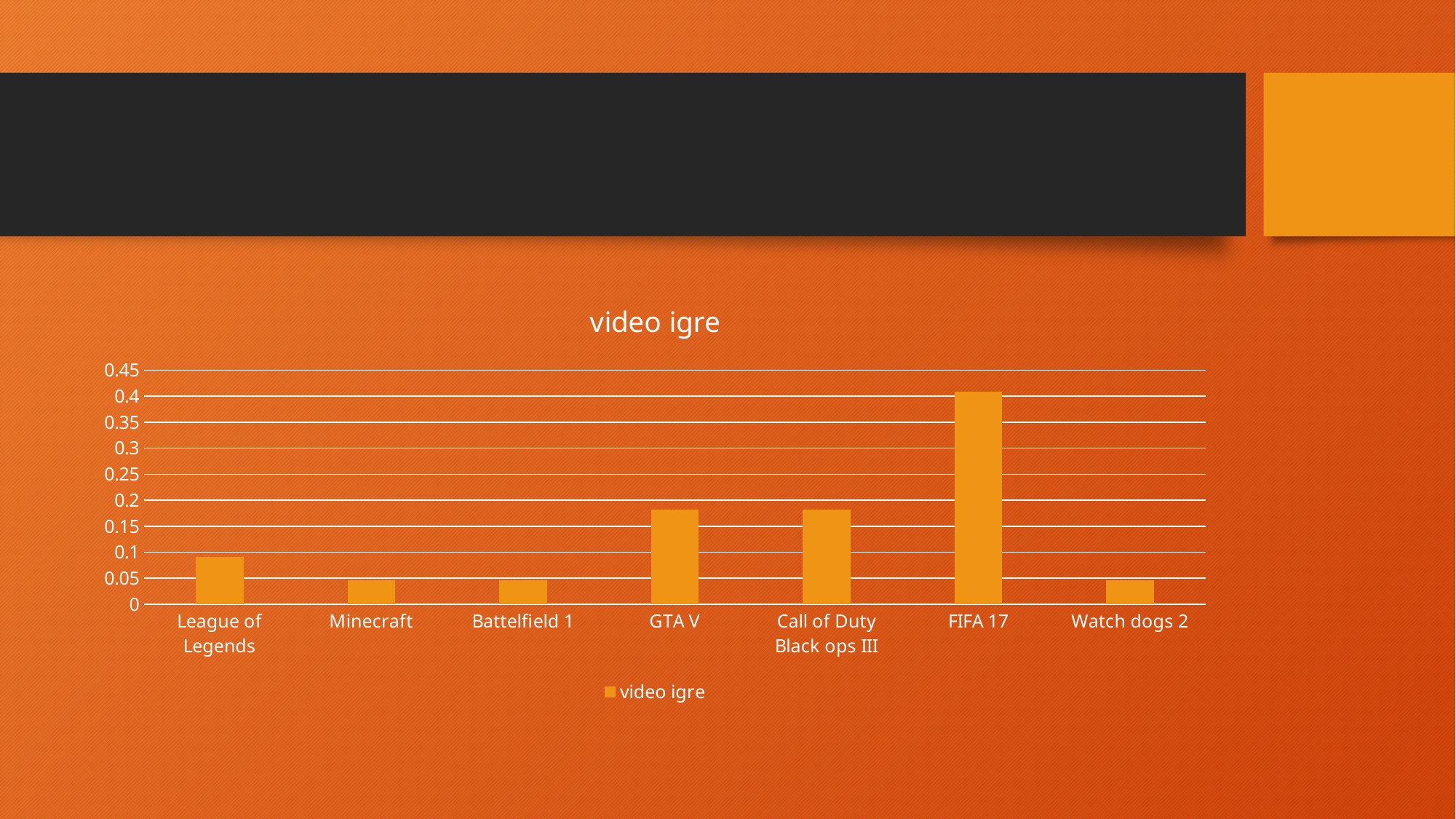
Is the value for FIFA 17 greater or less than 0.35? greater Is the value for GTA V greater or less than 0.15? greater Which is larger, the value for FIFA 17 or the value for GTA V? FIFA 17 What is the title of the chart? video igre Which category has the highest value? FIFA 17 How many series does the legend list? 1 Which is larger, the value for League of Legends or the value for Minecraft? League of Legends What kind of chart is shown on the slide? bar chart Is the value for Call of Duty Black ops III greater or less than 0.15? greater How many categories are shown on the x axis of the chart? 7